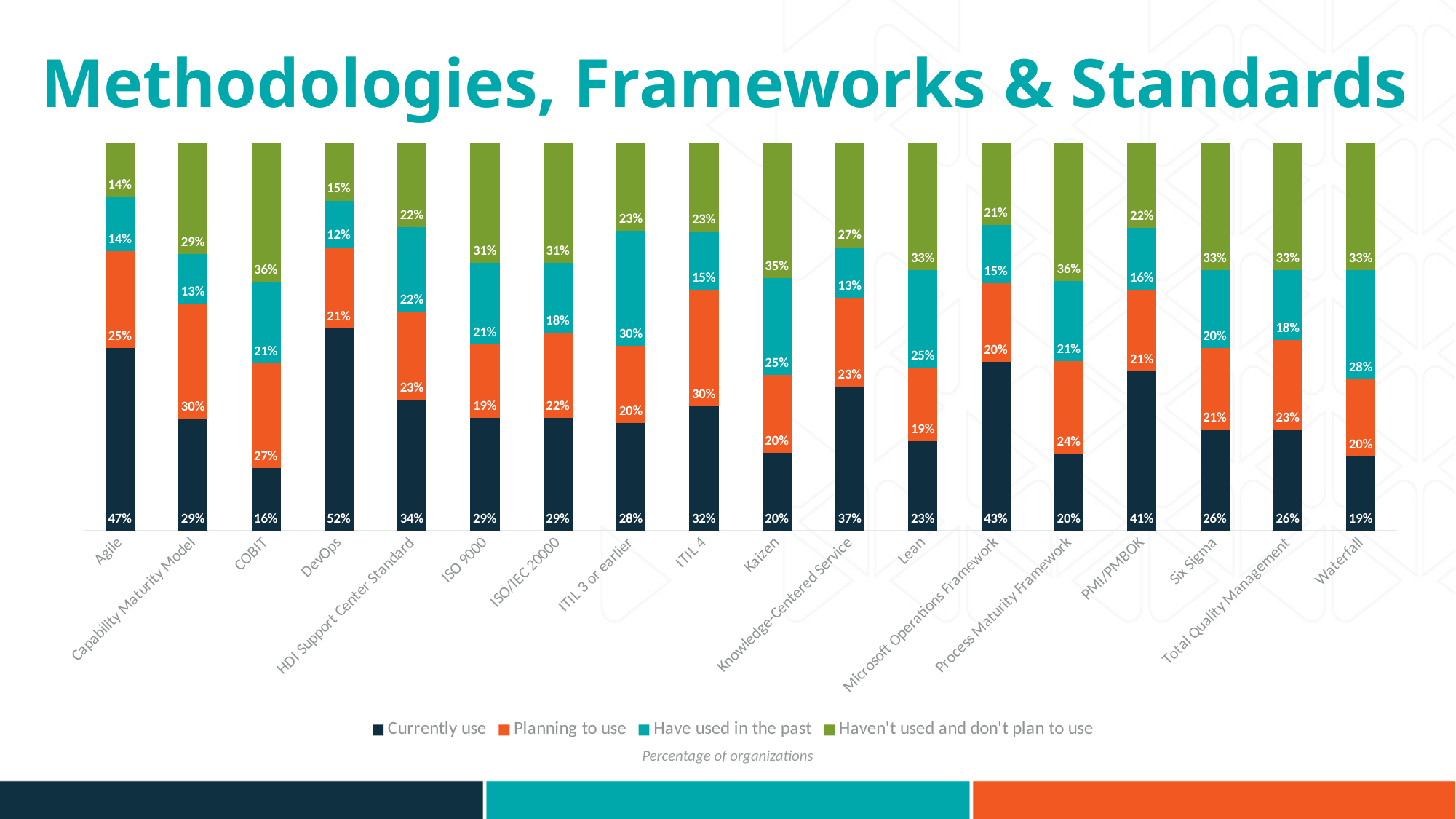
How many series does the legend list? 4 Which has a higher 'Currently use' percentage, PMI/PMBOK or Knowledge-Centered Service? PMI/PMBOK What percentage of organizations currently use Agile? 47% Which methodology has the lowest 'Have used in the past' percentage? DevOps What is the difference between the 'Currently use' percentages for DevOps and Agile? 5% What type of chart is shown on the slide? Stacked bar chart How many methodologies, frameworks and standards are shown on the x axis? 18 Which methodology has the highest 'Currently use' percentage? DevOps What percentage of organizations have used Waterfall in the past? 28% What percentage of organizations are planning to use COBIT? 27% What percentage of organizations haven't used and don't plan to use Kaizen? 35% Which methodology has the lowest 'Currently use' percentage? COBIT